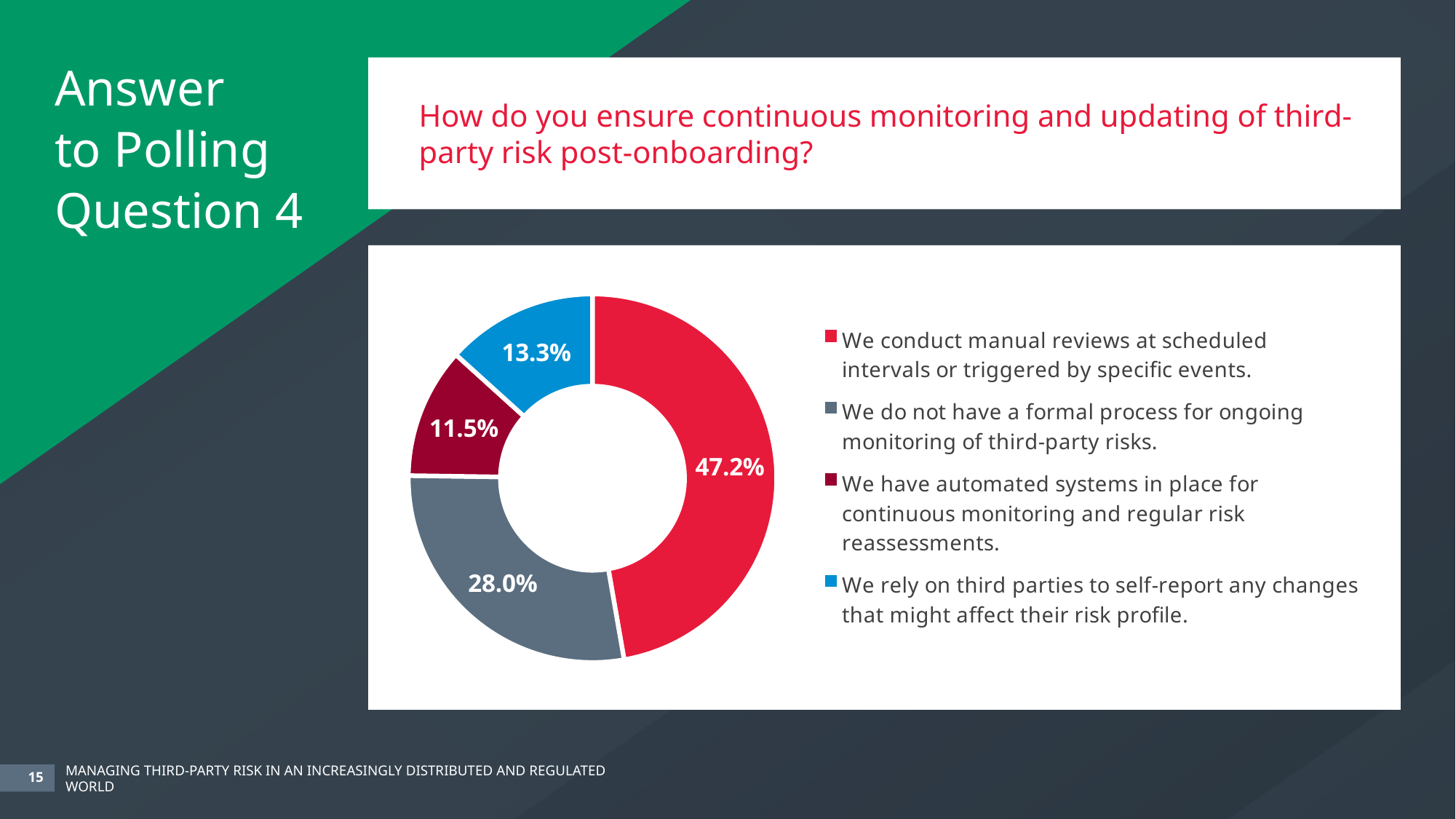
What is the difference in percentage points between the manual reviews response and the no formal process response? 19.2 Which is larger: the share for relying on third parties to self-report, or the share for having automated systems in place? We rely on third parties to self-report any changes that might affect their risk profile. What colour is the slice for 'We do not have a formal process for ongoing monitoring of third-party risks.'? Grey Which response has the largest share of the pie? We conduct manual reviews at scheduled intervals or triggered by specific events. What percentage of respondents said they have automated systems in place for continuous monitoring and regular risk reassessments? 11.5% What kind of chart is shown on the slide? Pie chart (doughnut) What is the combined share of the two smallest slices (automated systems and self-reporting)? 24.8% Which response has the smallest share of the pie? We have automated systems in place for continuous monitoring and regular risk reassessments. How many response categories are shown in the chart? 4 What percentage of respondents said they do not have a formal process for ongoing monitoring of third-party risks? 28.0% What percentage of respondents said they conduct manual reviews at scheduled intervals or triggered by specific events? 47.2% What percentage of respondents said they rely on third parties to self-report any changes that might affect their risk profile? 13.3%